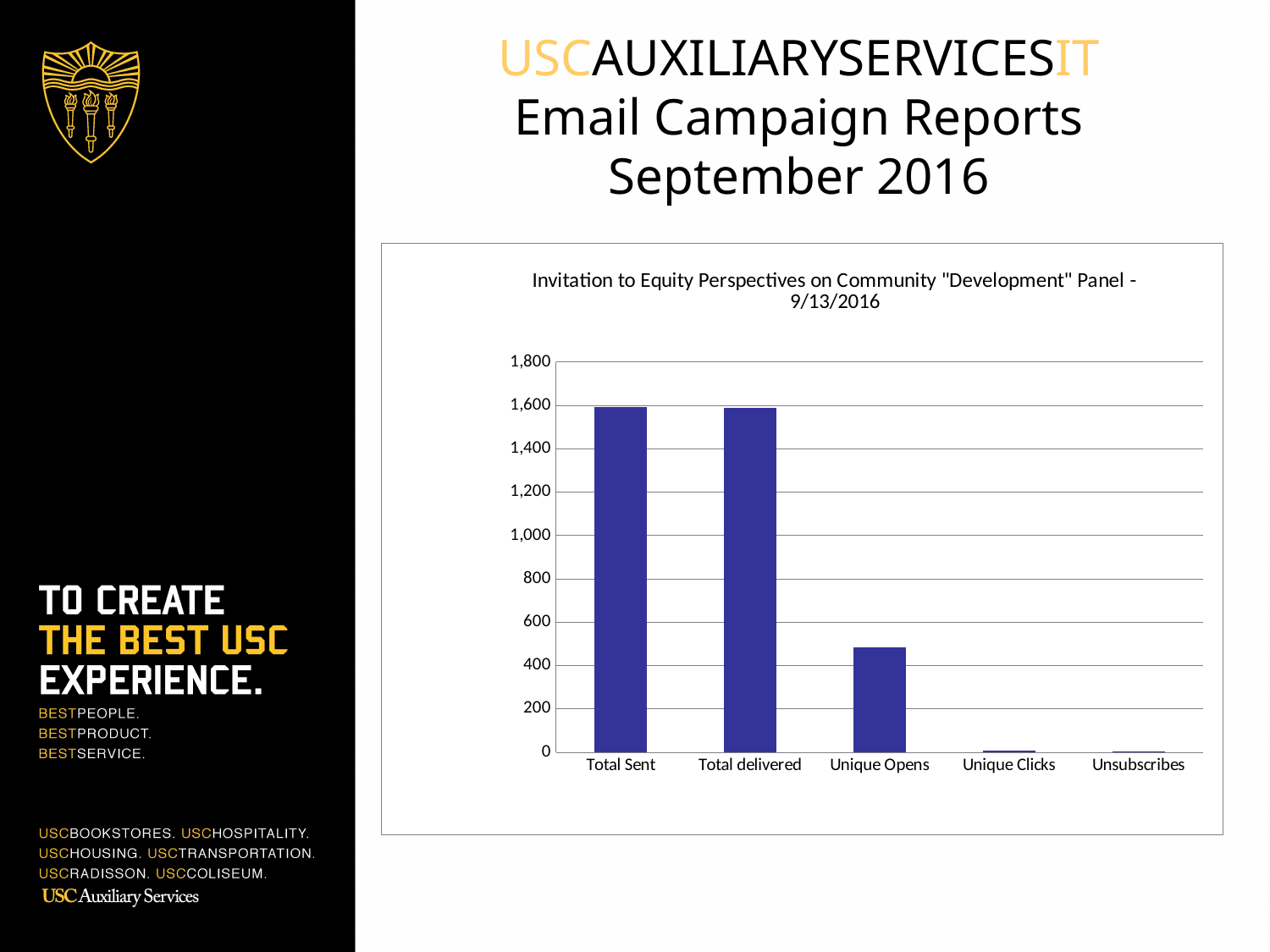
How many categories are plotted on the x axis of the chart? 5 What kind of chart is shown on the slide? bar chart What is the title of the chart? Invitation to Equity Perspectives on Community "Development" Panel - 9/13/2016 Is the value for Unique Opens greater or less than 600? less Is the value for Unique Opens greater or less than 400? greater Which is larger, the value for Total Sent or the value for Unique Opens? Total Sent Is the value for Total delivered greater or less than 1,800? less Do the values generally rise or fall from left to right along the x axis? fall Which is larger, the value for Unique Opens or the value for Unique Clicks? Unique Opens